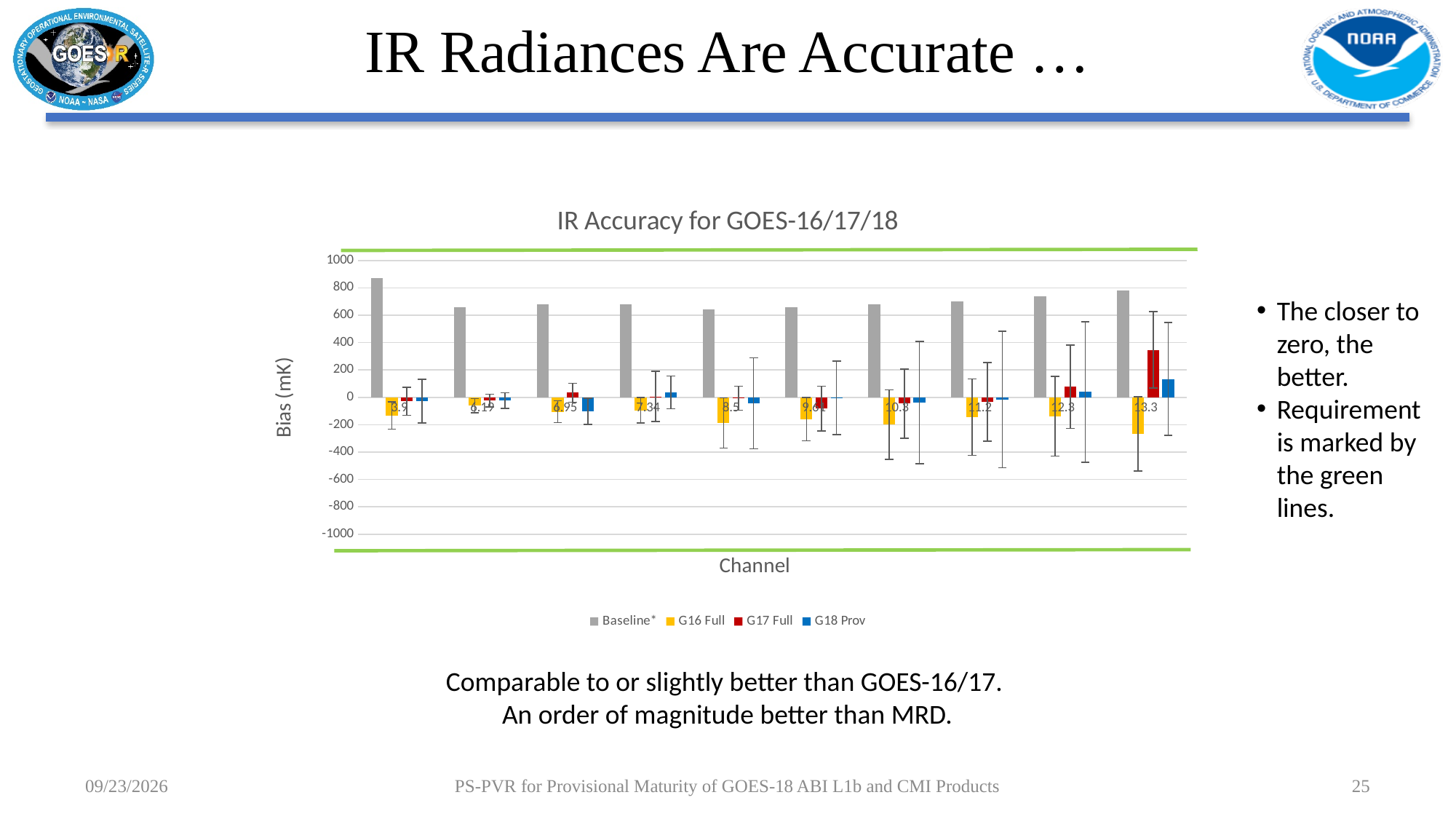
What kind of chart is shown on the slide? bar chart What is the label of the vertical axis? Bias (mK) Which is larger, the G17 Full value for channel 13.3 or for channel 12.3? channel 13.3 How many series does the chart legend list? 4 Which is larger, the Baseline* value for channel 3.9 or for channel 8.5? channel 3.9 How many channel categories are plotted on the x axis? 10 Is the G17 Full value for channel 13.3 greater or less than 200? greater Is the G16 Full value for channel 3.9 greater or less than 0? less Is the Baseline* value for channel 8.5 greater or less than 800? less Which channel has the highest Baseline* value? 3.9 What is the title of the chart? IR Accuracy for GOES-16/17/18